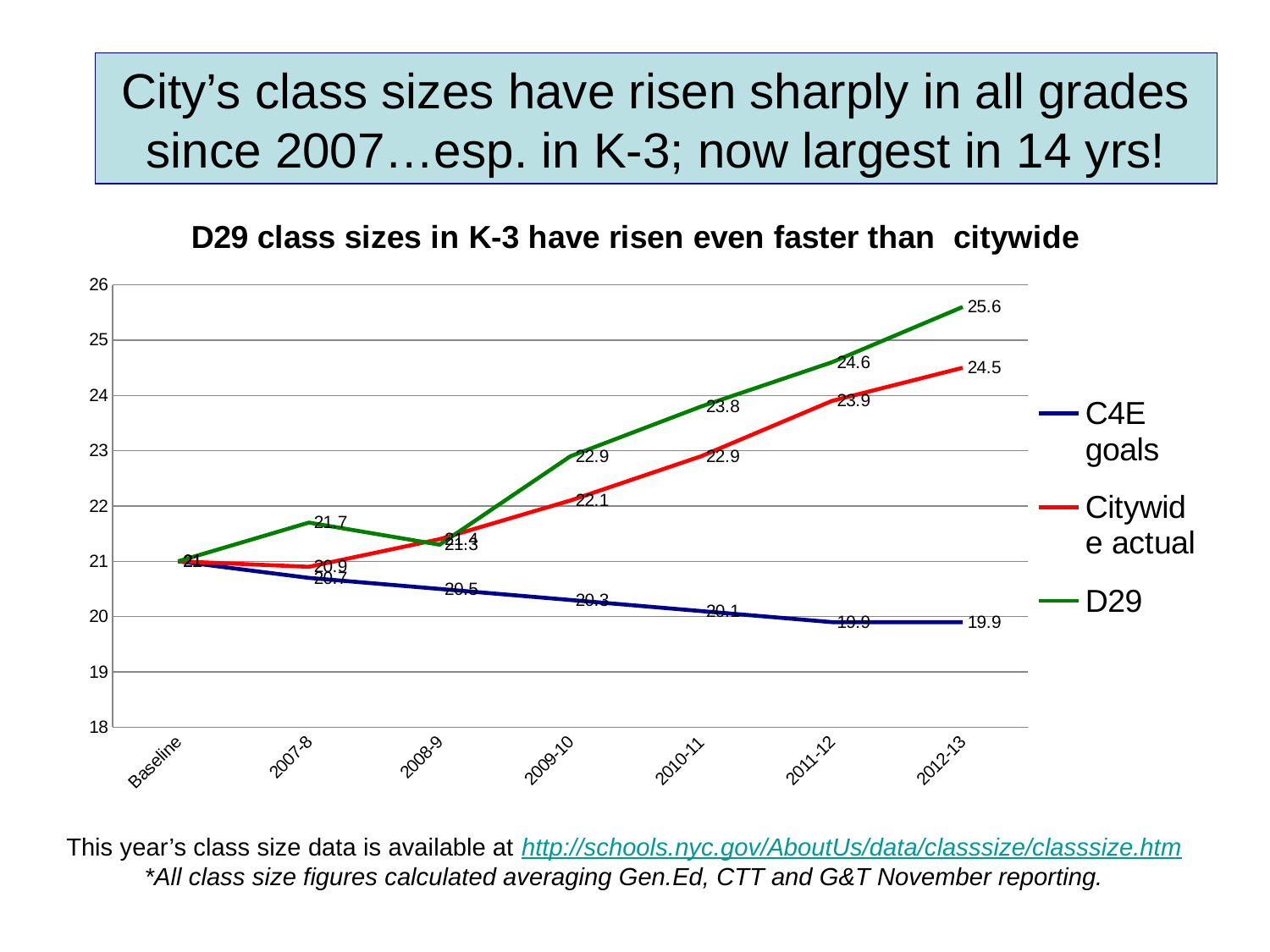
In which year does the D29 series reach its highest value? 2012-13 In 2011-12, which is larger: the D29 value or the Citywide actual value? D29 How many series does the legend list? 3 Do the C4E goals values rise or fall from Baseline to 2012-13? fall What is the C4E goals value for 2012-13? 19.9 What is the title of the chart? D29 class sizes in K-3 have risen even faster than citywide What is the D29 value for 2012-13? 25.6 What is the difference between the D29 and Citywide actual values in 2012-13? 1.1 What is the Citywide actual value for 2012-13? 24.5 How many points are plotted along the x axis for each series? 7 What kind of chart is shown on the slide? line chart What is the Citywide actual value for 2010-11? 22.9